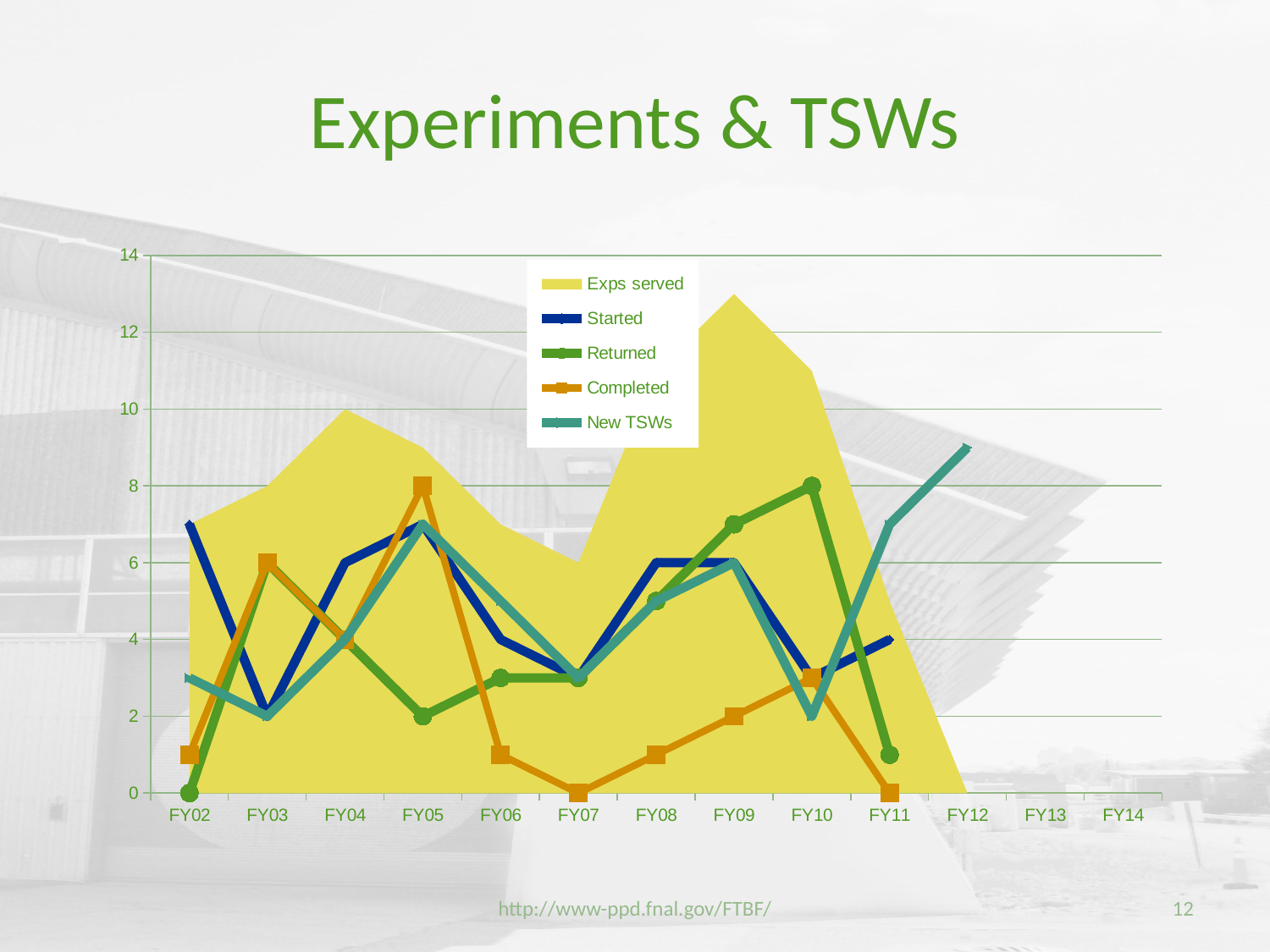
In which fiscal year is the Exps served value highest? FY09 In FY10, which is larger: Returned or Completed? Returned What is the Completed value in FY05? 8 Does the Completed series rise or fall from FY05 to FY07? fall How many series does the legend list? 5 What is the Returned value in FY10? 8 In which fiscal year is the Completed value highest? FY05 What is the Completed value in FY07? 0 Is the New TSWs value for FY12 greater or less than 8? greater Is the Exps served value for FY09 greater or less than 12? greater What is the difference between the Completed values in FY05 and FY07? 8 How many fiscal years are shown on the x axis? 13